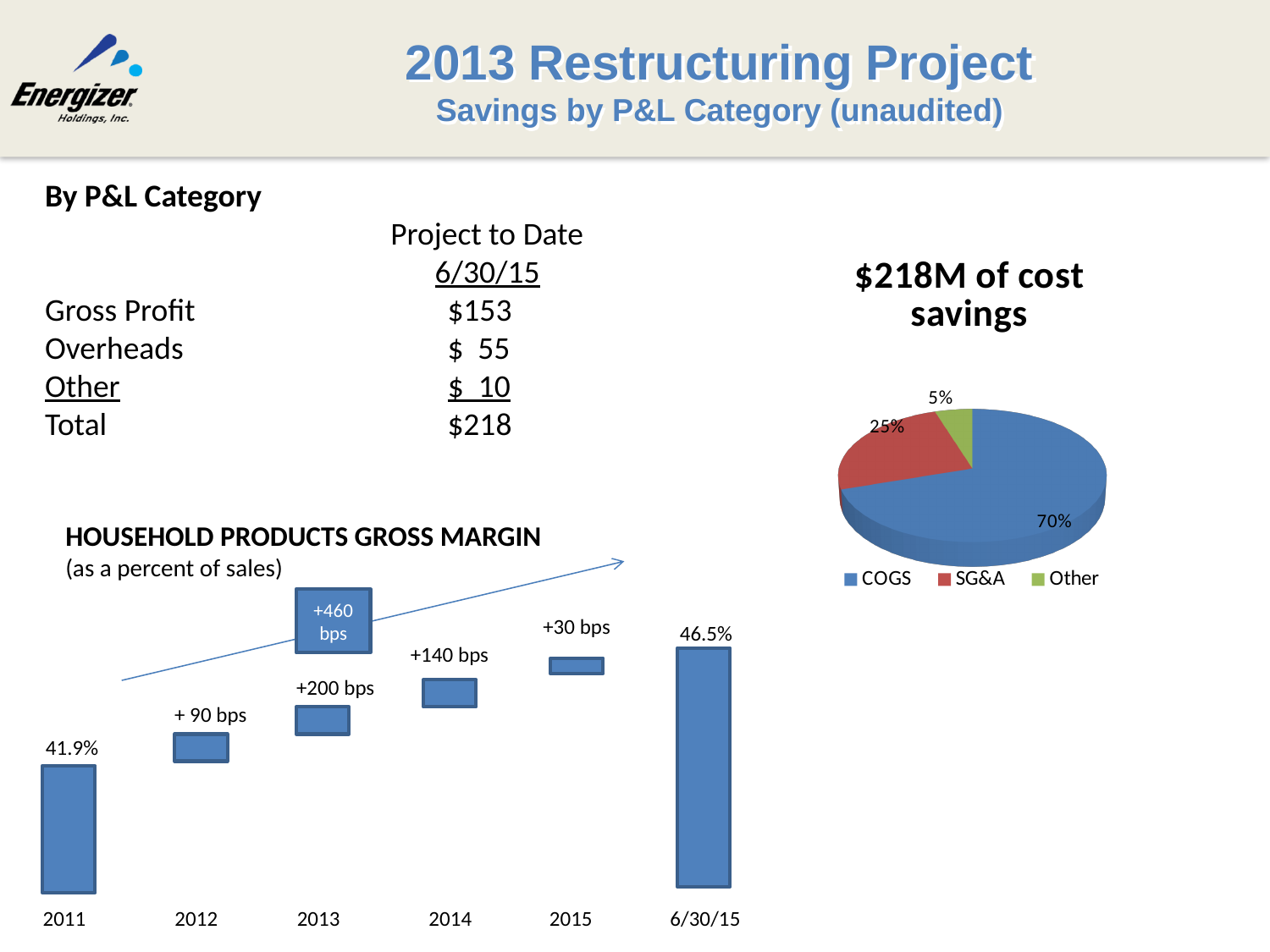
In the "HOUSEHOLD PRODUCTS GROSS MARGIN" chart, what is the value labelled for 6/30/15? 46.5% In the "HOUSEHOLD PRODUCTS GROSS MARGIN" chart, what is the difference between the 6/30/15 value and the 2011 value? 4.6 percentage points In the pie chart titled "$218M of cost savings", what share of the pie is COGS? 70% In the pie chart titled "$218M of cost savings", what share of the pie is Other? 5% In the "HOUSEHOLD PRODUCTS GROSS MARGIN" chart, what is the value labelled for 2011? 41.9% In the pie chart titled "$218M of cost savings", what is the difference in percentage points between the COGS and SG&A slices? 45 percentage points In the pie chart titled "$218M of cost savings", which category has the largest slice? COGS In the pie chart titled "$218M of cost savings", how many categories does the legend list? 3 In the pie chart titled "$218M of cost savings", which category has the smallest slice? Other In the pie chart titled "$218M of cost savings", what share of the pie is SG&A? 25% What kind of chart is the "$218M of cost savings" chart? Pie chart In the "HOUSEHOLD PRODUCTS GROSS MARGIN" chart, what is the change labelled for 2014? +140 bps